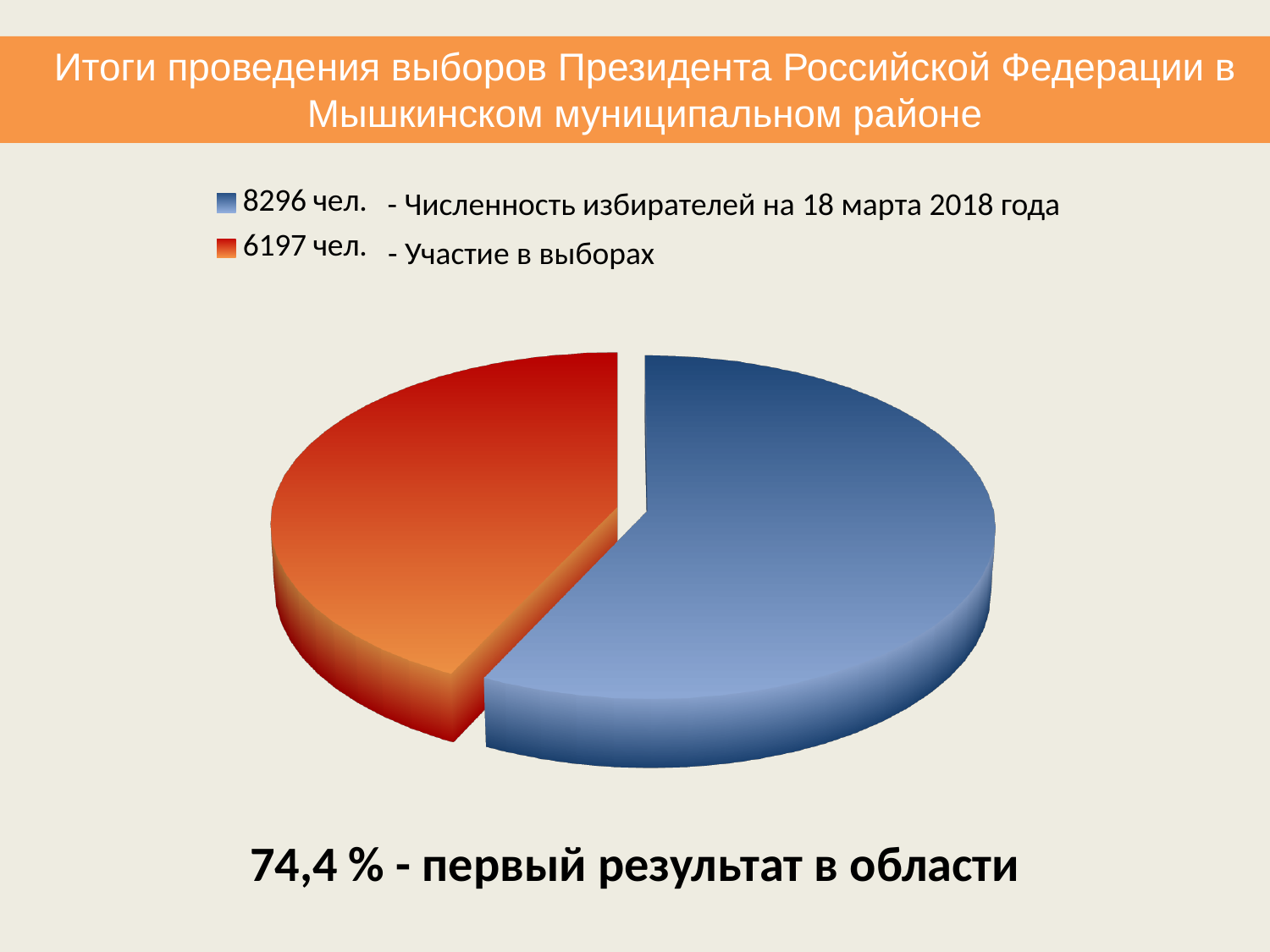
What is the difference between 8296 чел. and 6197 чел. shown in the legend? 2099 чел. Is the value for 'Численность избирателей на 18 марта 2018 года' larger or smaller than the value for 'Участие в выборах'? larger What percentage is stated in the text below the pie chart? 74,4 % What is the value for 'Участие в выборах'? 6197 чел. How many slices does the pie chart have? 2 Which category has the larger value in the pie chart? Численность избирателей на 18 марта 2018 года What value is shown in the legend for the blue slice of the pie chart? 8296 чел. What value is shown in the legend for the red slice of the pie chart? 6197 чел. Which category has the smaller value in the pie chart? Участие в выборах What is the value for 'Численность избирателей на 18 марта 2018 года'? 8296 чел. What colour is the slice representing 'Участие в выборах'? red What kind of chart is shown on the slide? pie chart